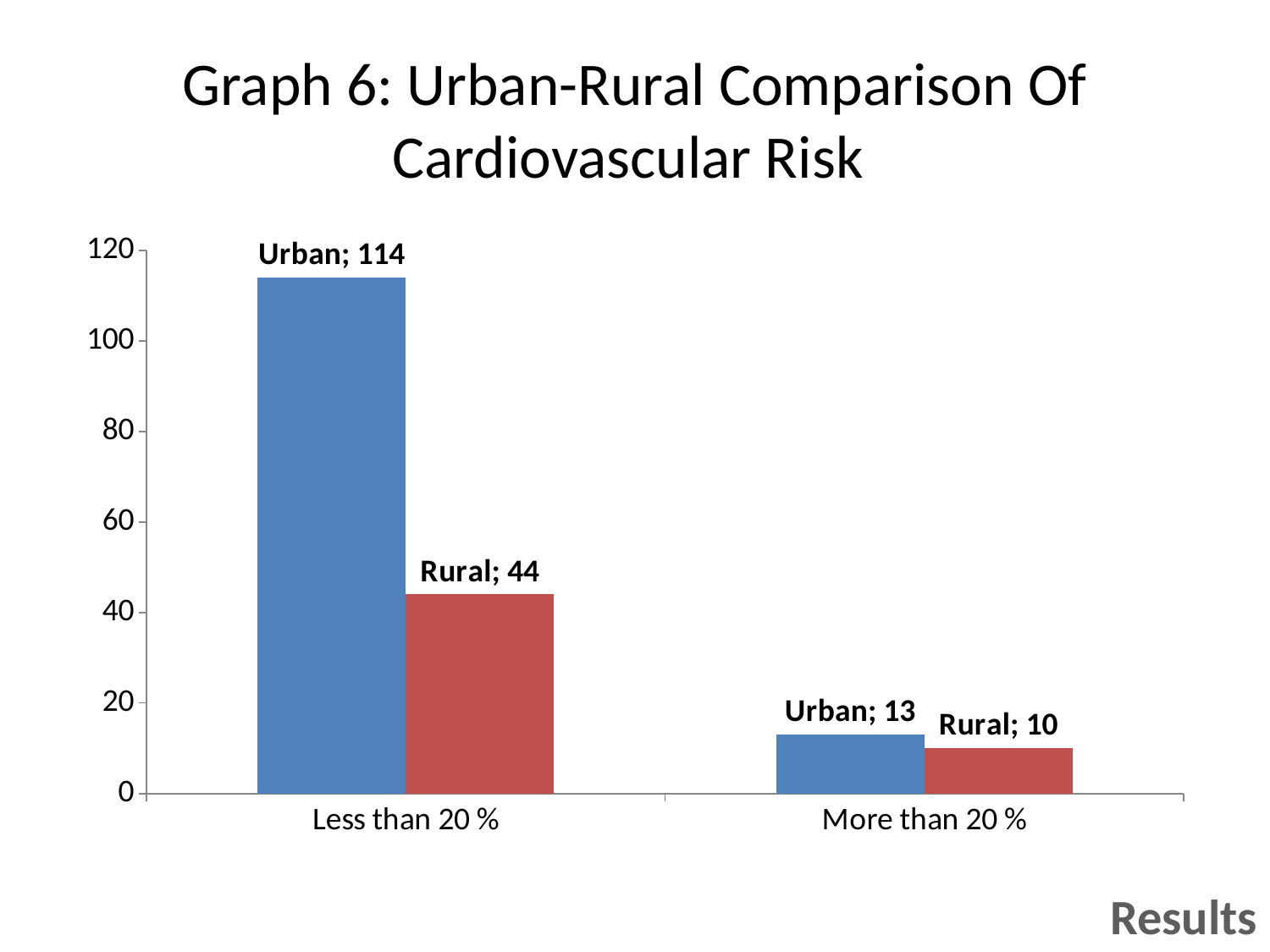
What kind of chart is shown on the slide? Bar chart What is the Urban value for the 'More than 20 %' category? 13 Which bar has the highest value on the chart? Urban, Less than 20 % What is the Rural value for the 'More than 20 %' category? 10 What is the Rural value for the 'Less than 20 %' category? 44 Which bar has the lowest value on the chart? Rural, More than 20 % What is the difference between the Urban and Rural values for 'More than 20 %'? 3 What is the difference between the Urban and Rural values for 'Less than 20 %'? 70 Which is larger: the Rural value for 'Less than 20 %' or the Urban value for 'More than 20 %'? Rural value for 'Less than 20 %' What is the title of the chart? Graph 6: Urban-Rural Comparison Of Cardiovascular Risk How many categories are shown on the x axis? 2 What is the Urban value for the 'Less than 20 %' category? 114